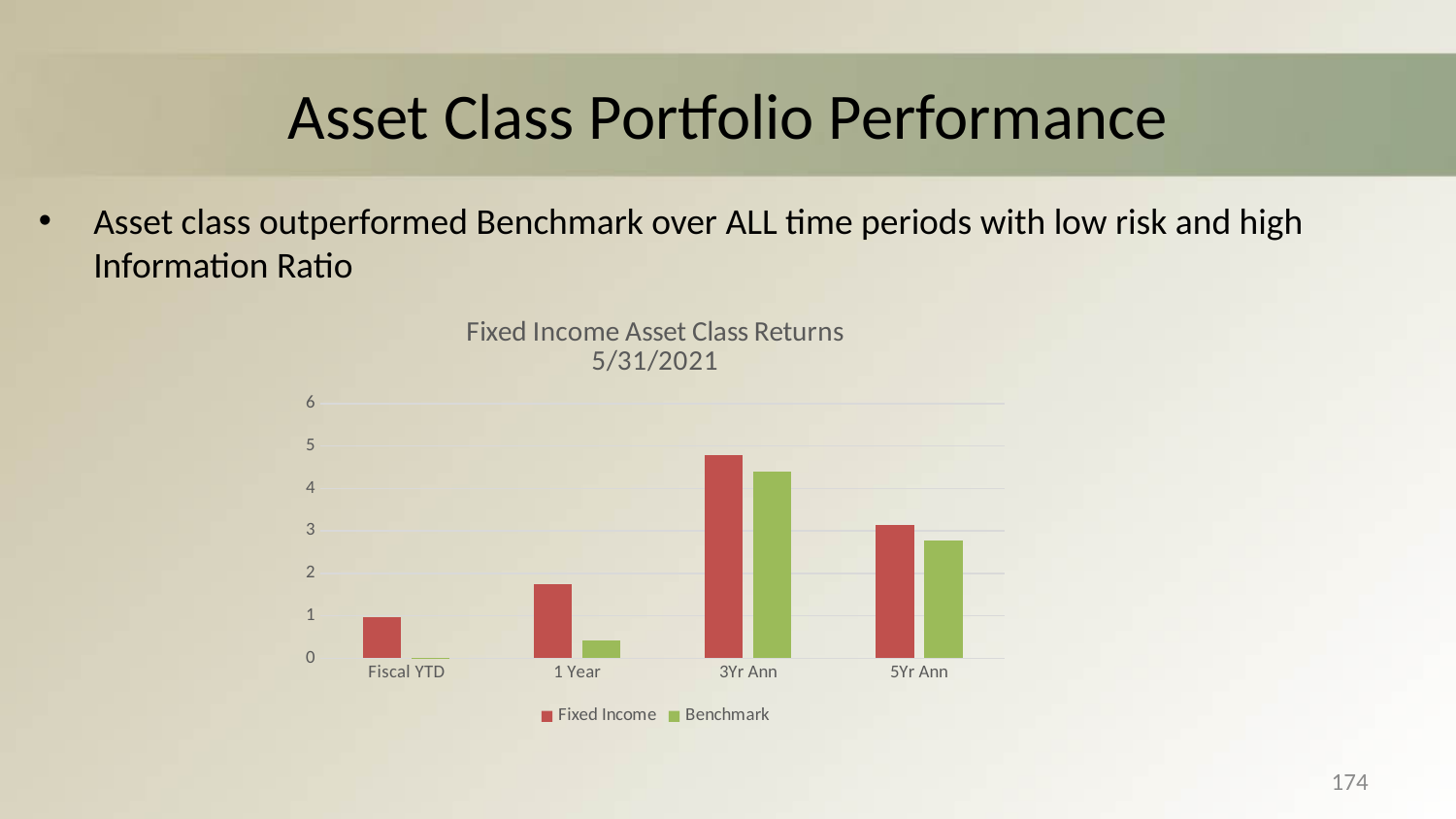
Which category has the lowest Fixed Income value? Fiscal YTD What kind of chart is shown on the slide? bar chart How many time-period categories are shown on the x axis of the chart? 4 For 1 Year, which is larger: Fixed Income or Benchmark? Fixed Income Which category has the highest Fixed Income value? 3Yr Ann Is the Fixed Income value for 3Yr Ann greater or less than 4? greater Is the Benchmark value for 1 Year greater or less than 1? less Is the Fixed Income value for 5Yr Ann greater or less than 2? greater Which category has the lowest Benchmark value? Fiscal YTD How many series does the chart's legend list? 2 Which series is shown in green in the chart? Benchmark What is the title of the chart? Fixed Income Asset Class Returns 5/31/2021